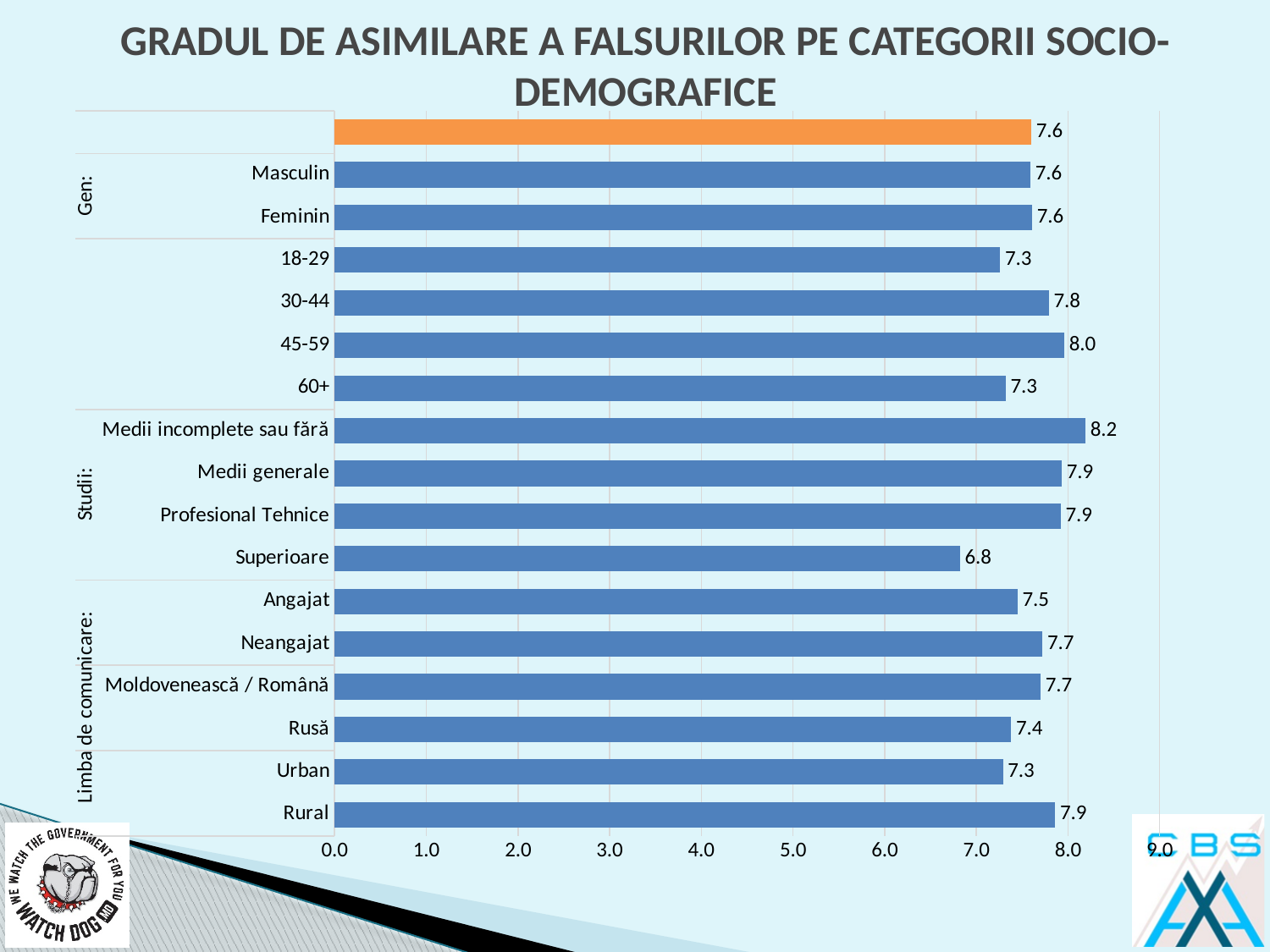
What kind of chart is shown on the slide? Bar chart What is the value for Rural? 7.9 Which labeled category has the highest value? Medii incomplete sau fără What colour is the topmost bar of the chart? Orange What is the value for 45-59? 8.0 What is the value for Masculin? 7.6 Which is larger, the value for 30-44 or the value for 18-29? 30-44 Which category has the lowest value? Superioare What is the value for Rusă? 7.4 What is the difference between the values for Rural and Urban? 0.6 What is the value for Superioare? 6.8 Is the value for Medii incomplete sau fără greater or less than 8.0? greater